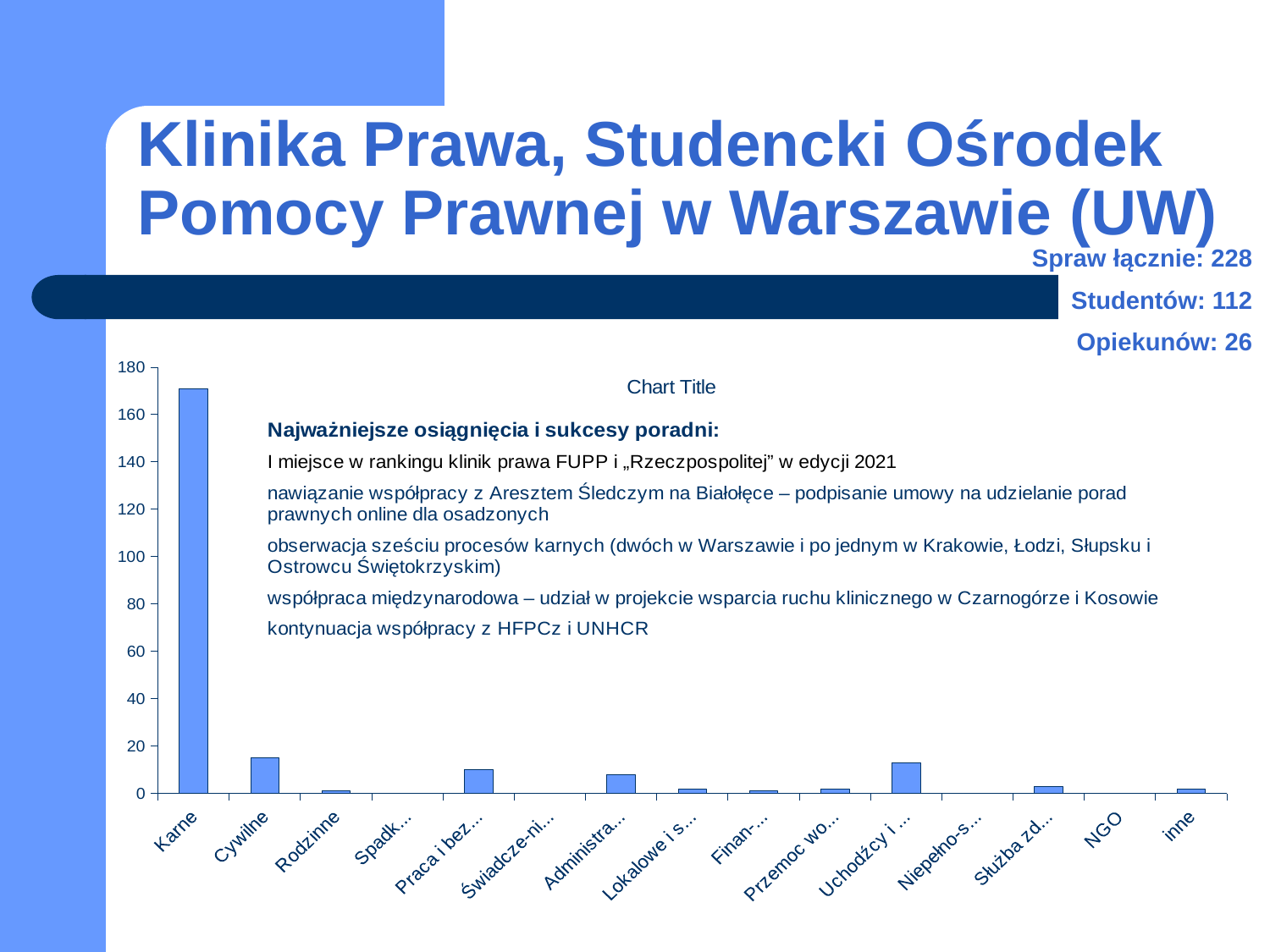
Is the value for Cywilne greater or less than 20? less Which is larger, the value for Cywilne or the value for Praca i bez...? Cywilne Is the value for Uchodźcy i ... greater or less than 20? less What is the title shown on the chart? Chart Title Is the value for Karne greater or less than 160? greater Which is larger, the value for Karne or the value for Cywilne? Karne What is the highest value shown on the y axis of the chart? 180 Which is larger, the value for Uchodźcy i ... or the value for Administra...? Uchodźcy i ... What kind of chart is shown on the slide? bar chart How many categories are shown on the x axis of the chart? 15 Which category has the highest bar in the chart? Karne